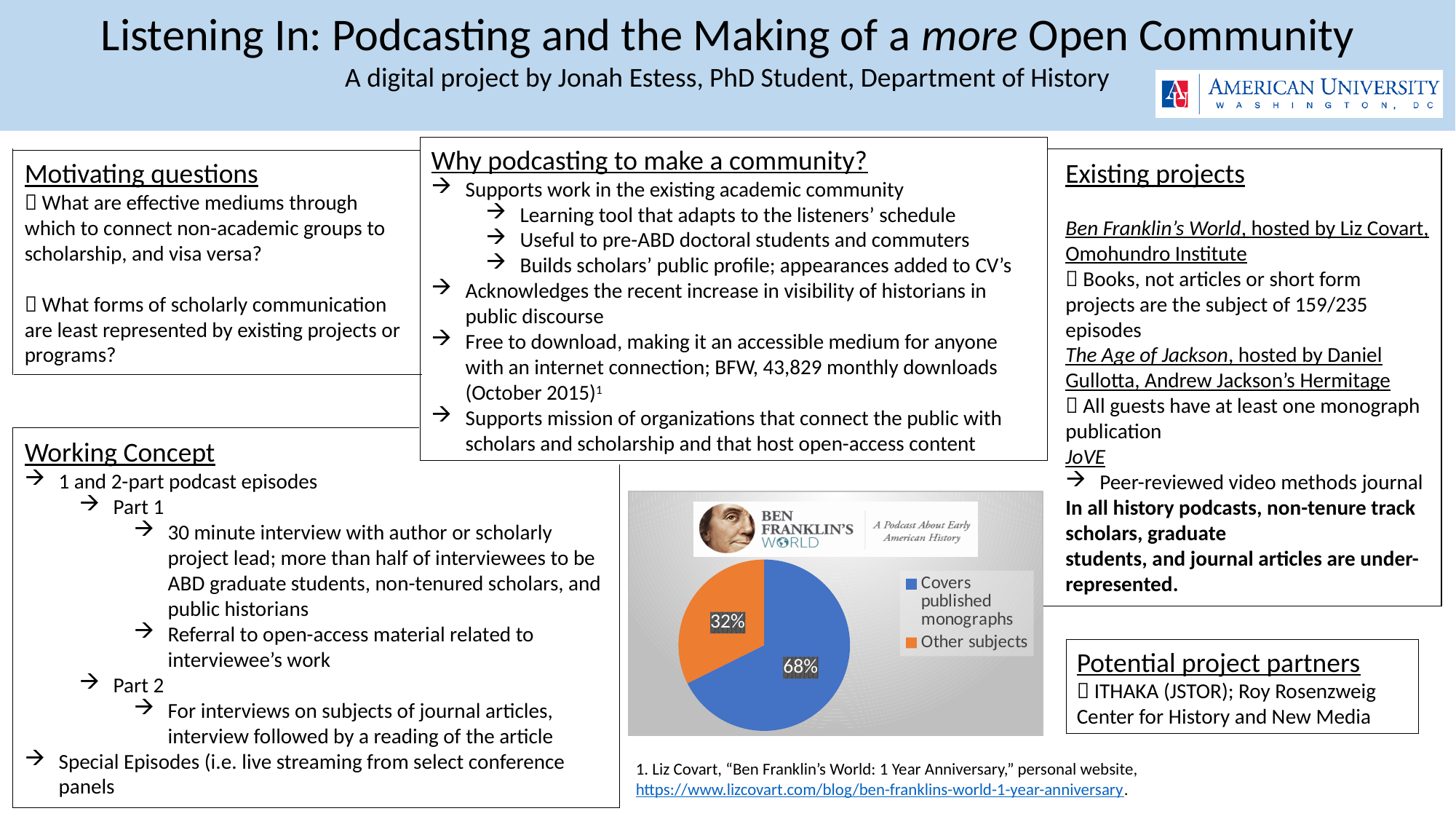
What share of the pie does "Covers published monographs" represent? 68% What is the difference in percentage points between the "Covers published monographs" slice and the "Other subjects" slice? 36 Which slice of the pie chart is the largest? Covers published monographs How many entries does the pie chart's legend list? 2 How many slices does the pie chart have? 2 What kind of chart is shown on the slide? pie chart Which is larger in the pie chart: "Covers published monographs" or "Other subjects"? Covers published monographs Which slice of the pie chart is the smallest? Other subjects What colour is the "Other subjects" slice in the pie chart? orange What colour is the "Covers published monographs" slice in the pie chart? blue What share of the pie does "Other subjects" represent? 32%